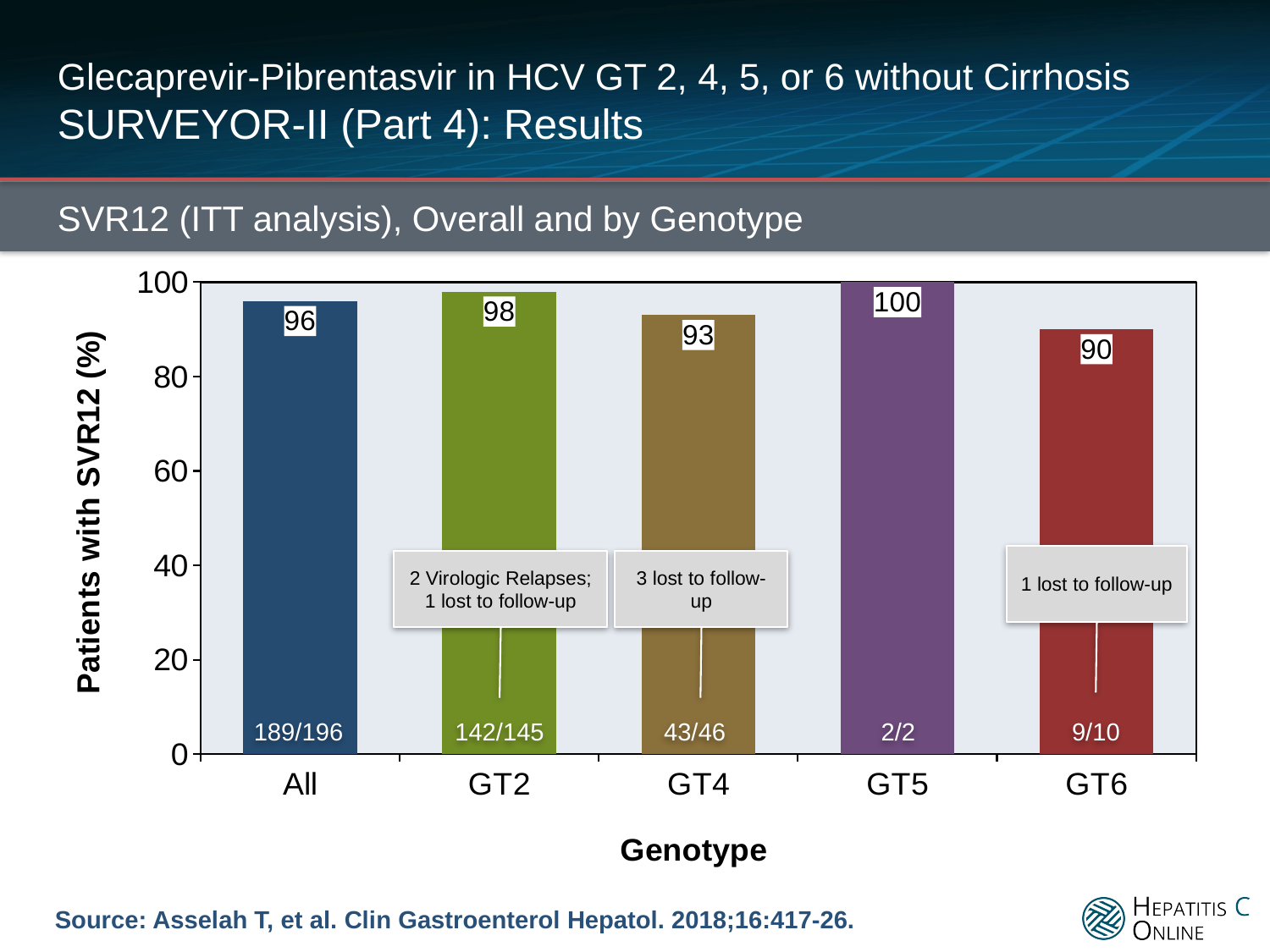
What does the annotation above the GT6 bar say? 1 lost to follow-up Which genotype group has the lowest SVR12 rate? GT6 What is the label of the y axis? Patients with SVR12 (%) Which genotype group has the highest SVR12 rate? GT5 What is the SVR12 rate for the GT4 group? 93 Which has a higher SVR12 rate, GT4 or GT5? GT5 What kind of chart is shown on the slide? Bar chart What is the difference in SVR12 rate between GT2 and GT6? 8 What fraction of patients achieved SVR12 in the GT2 group? 142/145 How many patients were in the GT5 group? 2 What is the SVR12 rate for the All group? 96 How many genotype categories are shown on the x axis? 5